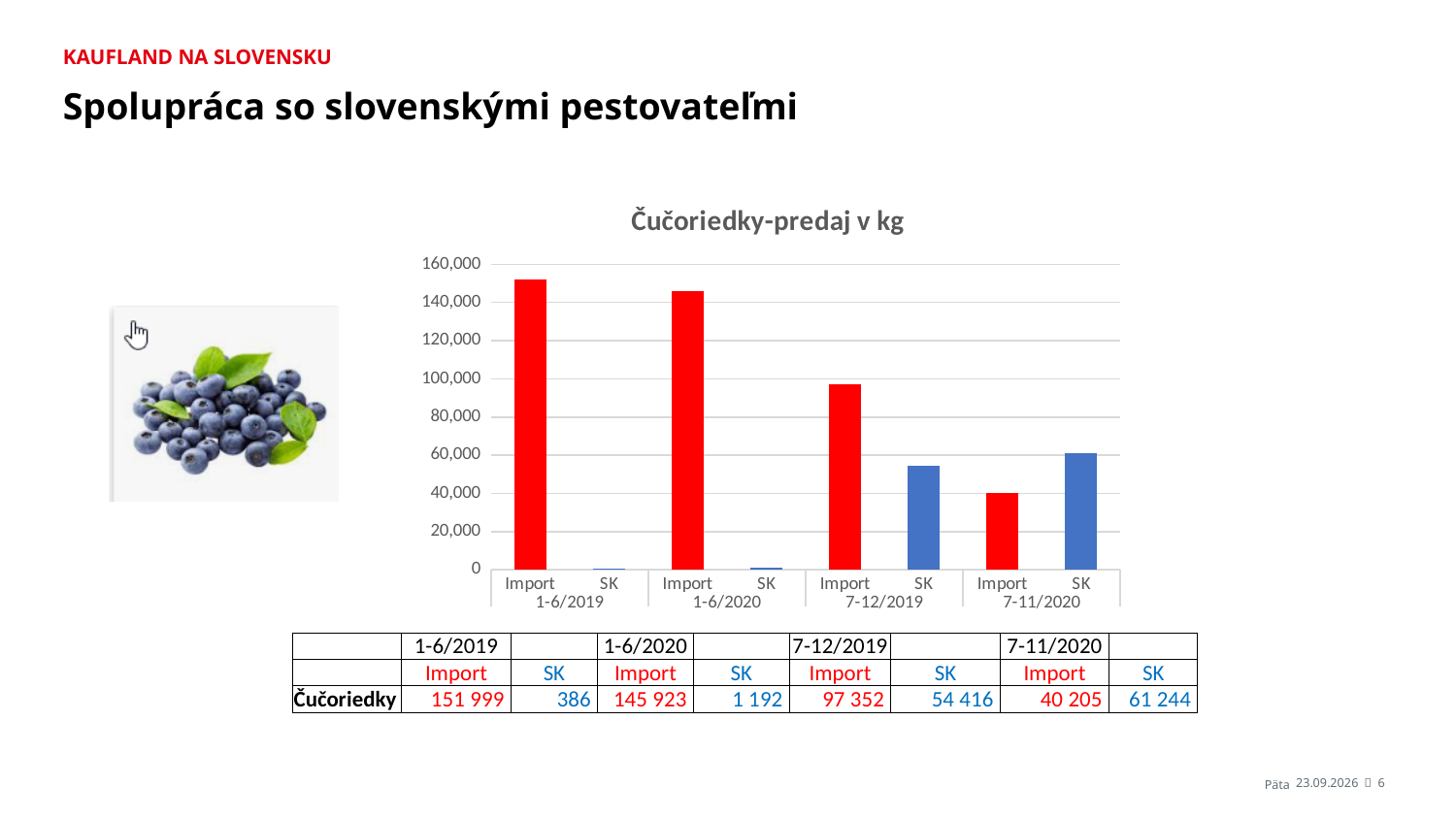
What is the SK value for 7-11/2020? 61 244 What kind of chart is shown on the slide? bar chart What is the SK value for 7-12/2019? 54 416 Do the Import values rise or fall across the four periods from left to right? fall What is the title of the chart? Čučoriedky-predaj v kg Which is larger for 7-11/2020, Import or SK? SK What is the difference between the Import value for 1-6/2019 and the Import value for 1-6/2020? 6 076 What is the Import value for 1-6/2019? 151 999 Is the Import value for 7-12/2019 greater or less than 100,000? less Which bar has the highest value in the chart? Import 1-6/2019 How many bars are plotted in the chart? 8 Which bar has the lowest value in the chart? SK 1-6/2019